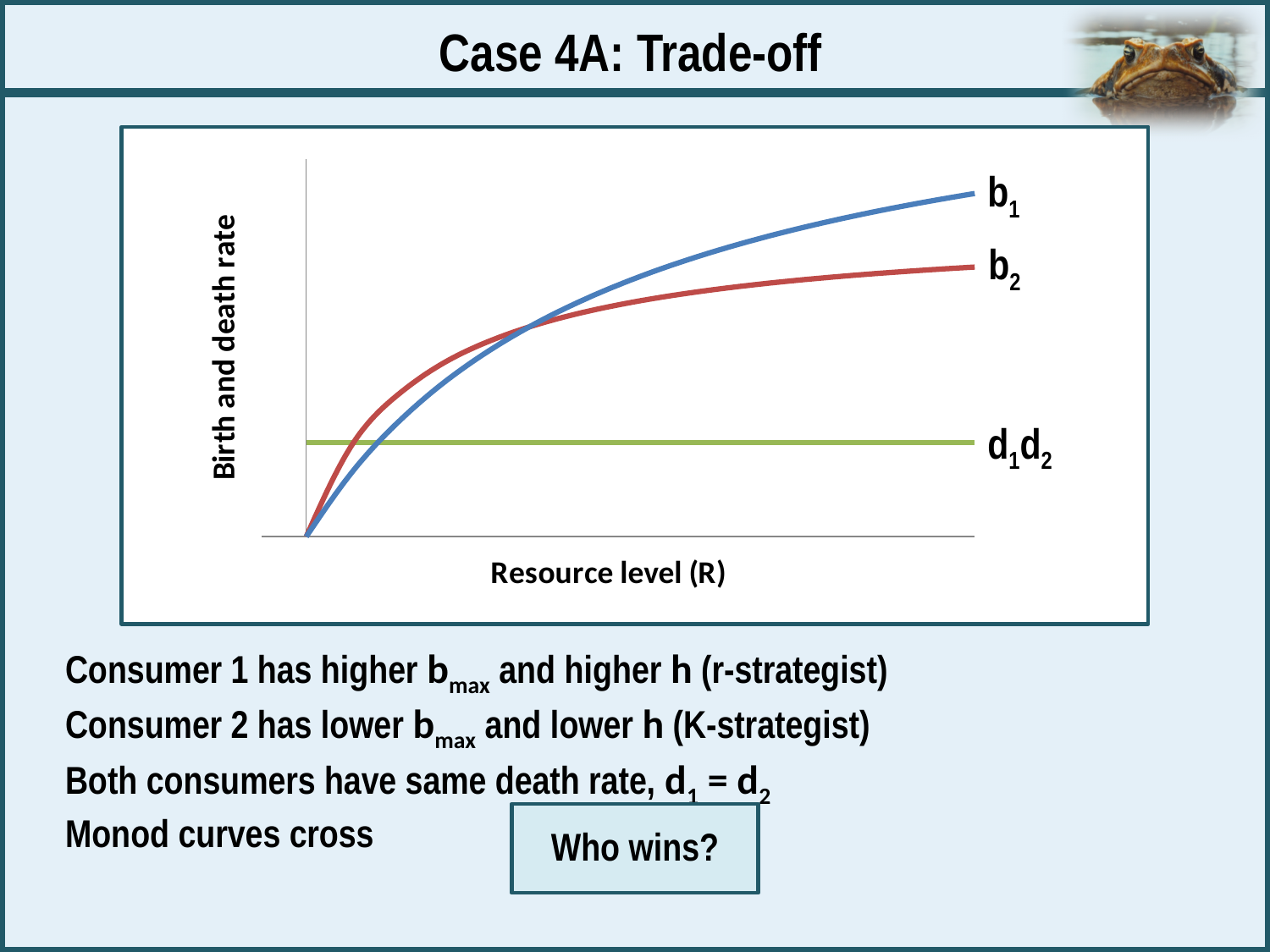
At low resource levels, near the left of the chart, which curve is higher, b1 or b2? b2 Does the b2 curve rise or fall as resource level increases? rise Does the b1 curve rise or fall as resource level increases? rise What kind of chart is shown on the slide? line chart Which curve reaches the highest value at the right end of the chart? b1 What is the label of the x axis? Resource level (R) Which line is the lowest at the right end of the chart? d1d2 At the highest resource level shown, which curve is higher, b1 or b2? b1 Do the b1 and b2 curves cross each other? yes Does the d1d2 line rise, fall, or stay flat as resource level increases? stay flat What is the label of the y axis? Birth and death rate How many curves are plotted on the chart? 3